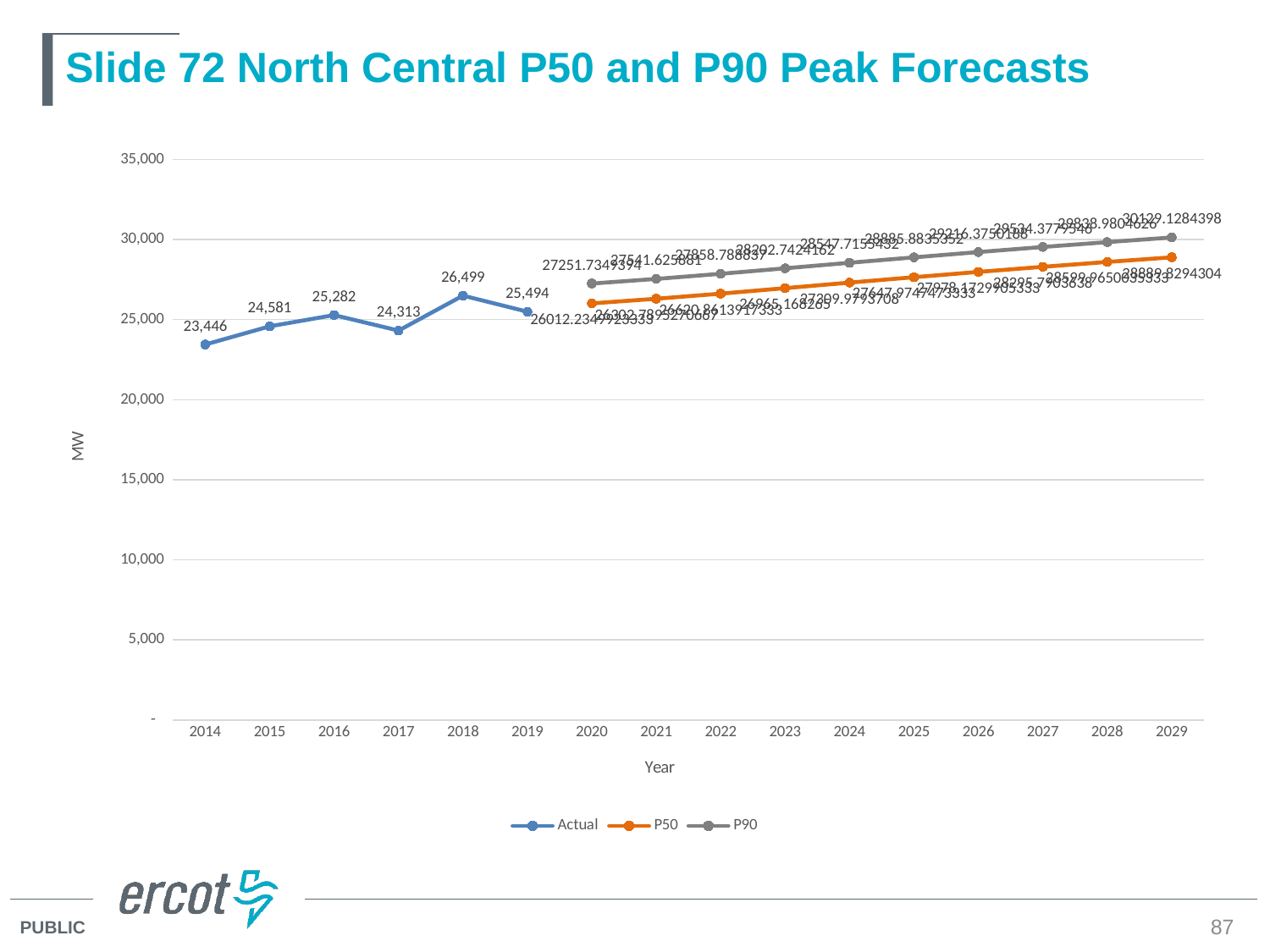
Which is larger, the Actual value for 2016 or for 2019? 2019 What kind of chart is shown on the slide? line chart How many series does the legend list? 3 In which year is the Actual series lowest? 2014 What is the difference between the Actual values for 2015 and 2014? 1,135 Is the P50 value for 2029 greater or less than 30,000? less Does the P90 series rise or fall from 2020 to 2029? rise How many years are shown on the x axis? 16 What is the Actual value for 2014? 23,446 What is the difference between the Actual values for 2018 and 2017? 2,186 In which year is the Actual series highest? 2018 What is the Actual value for 2018? 26,499